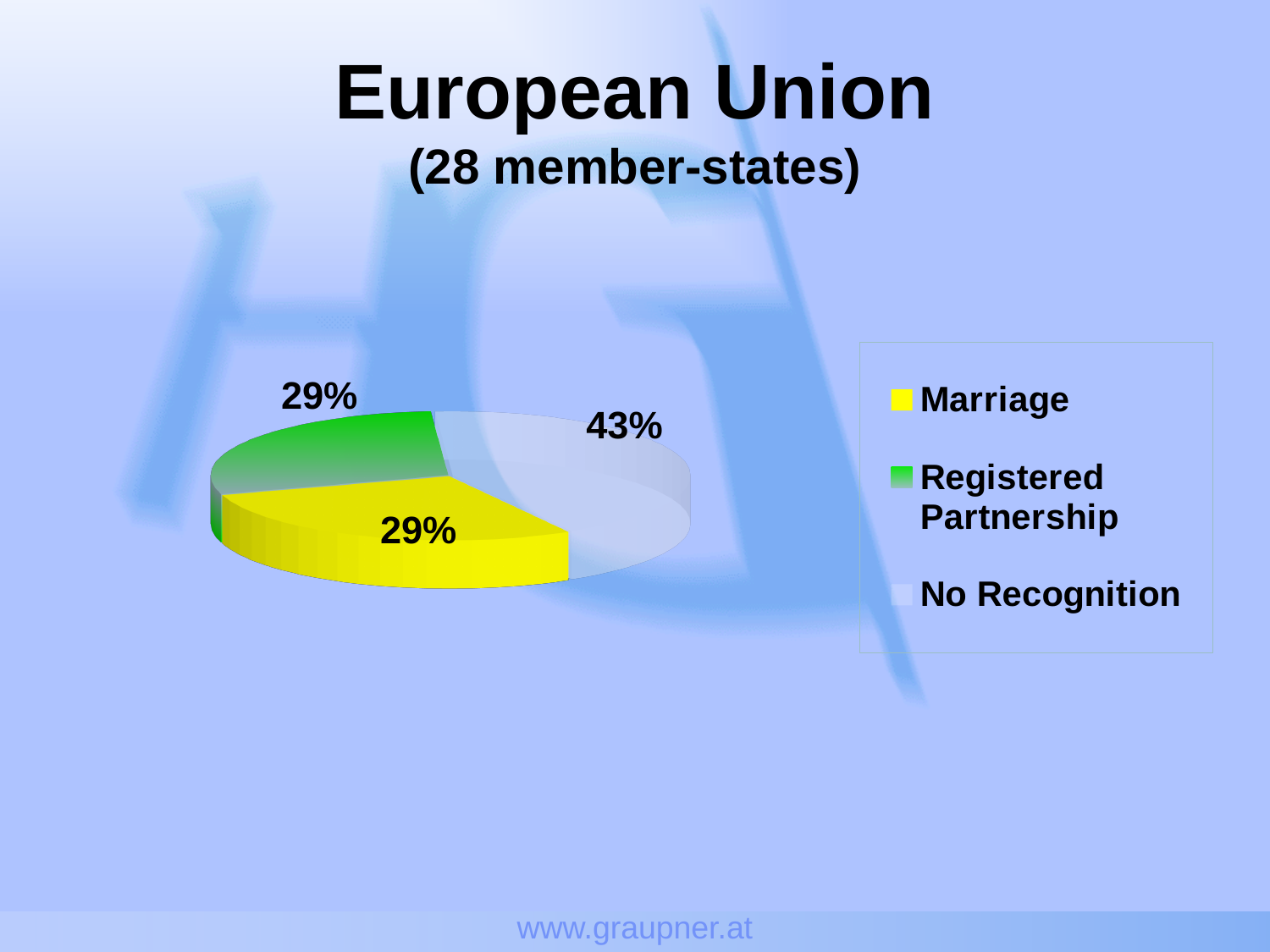
Which category has the largest slice of the pie? No Recognition Which slice is larger, No Recognition or Registered Partnership? No Recognition How many entries does the legend list? 3 According to the slide title, how many member-states does the European Union have? 28 What is the difference in percentage points between the No Recognition slice and the Marriage slice? 14 What share of the pie does the No Recognition slice represent? 43% What kind of chart is shown on the slide? Pie chart What percentage is shown for the Marriage slice? 29% What percentage is shown for the Registered Partnership slice? 29% What colour is the Marriage slice in the pie chart? Yellow Do the Marriage and Registered Partnership slices have the same percentage? Yes How many slices does the pie chart have? 3